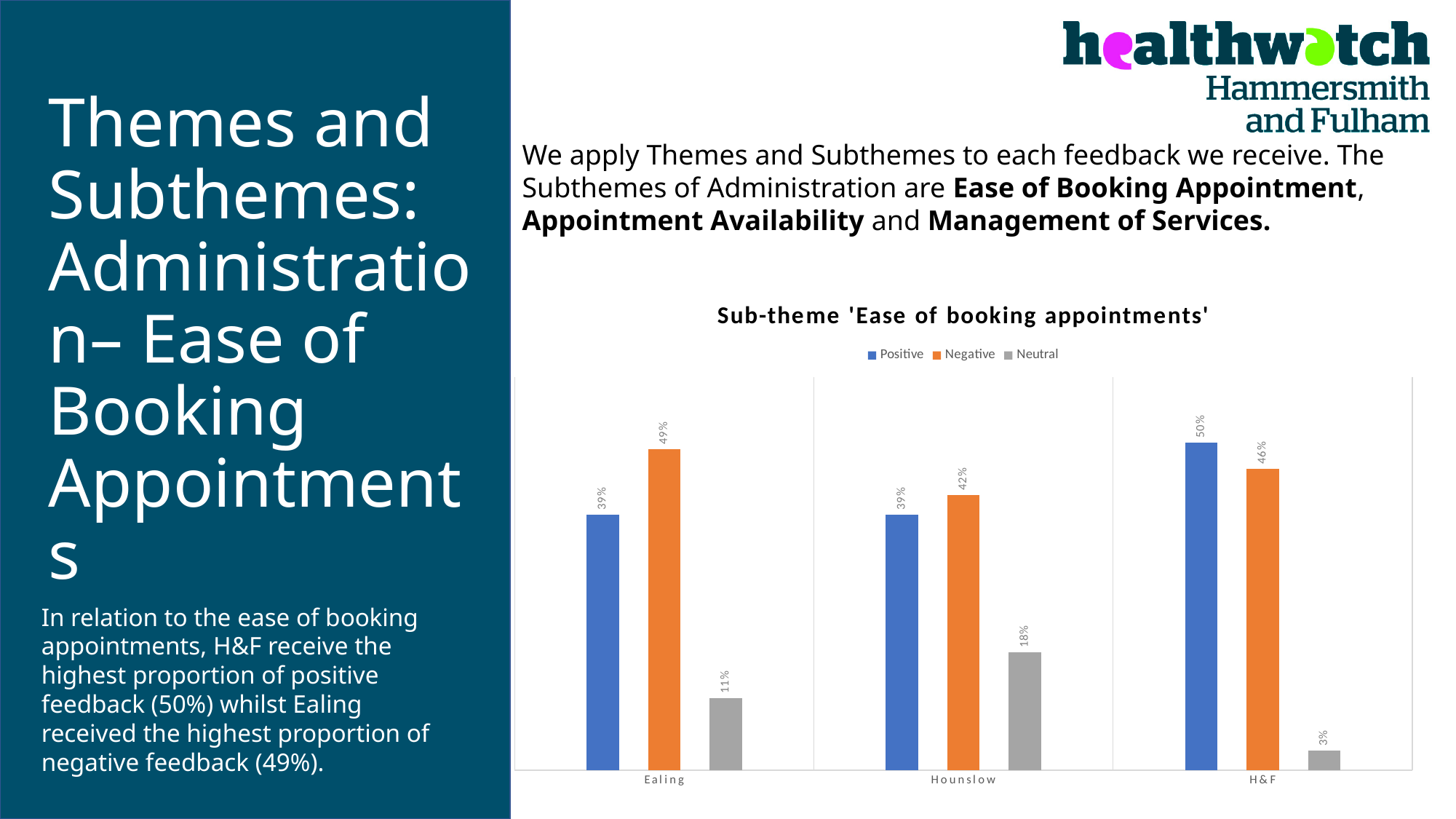
What kind of chart is shown on the slide? Bar chart What is the Positive value for Ealing? 39% Which colour represents the Negative series in the chart? Orange Which category has the highest Positive value? H&F What is the title of the chart? Sub-theme 'Ease of booking appointments' Which category has the lowest Neutral value? H&F How many categories are shown on the x axis? 3 What is the difference between the Negative and Positive values for Ealing? 10% What is the Negative value for H&F? 46% Which is larger for Hounslow, the Positive value or the Negative value? Negative How many series does the legend list? 3 What is the Neutral value for Hounslow? 18%